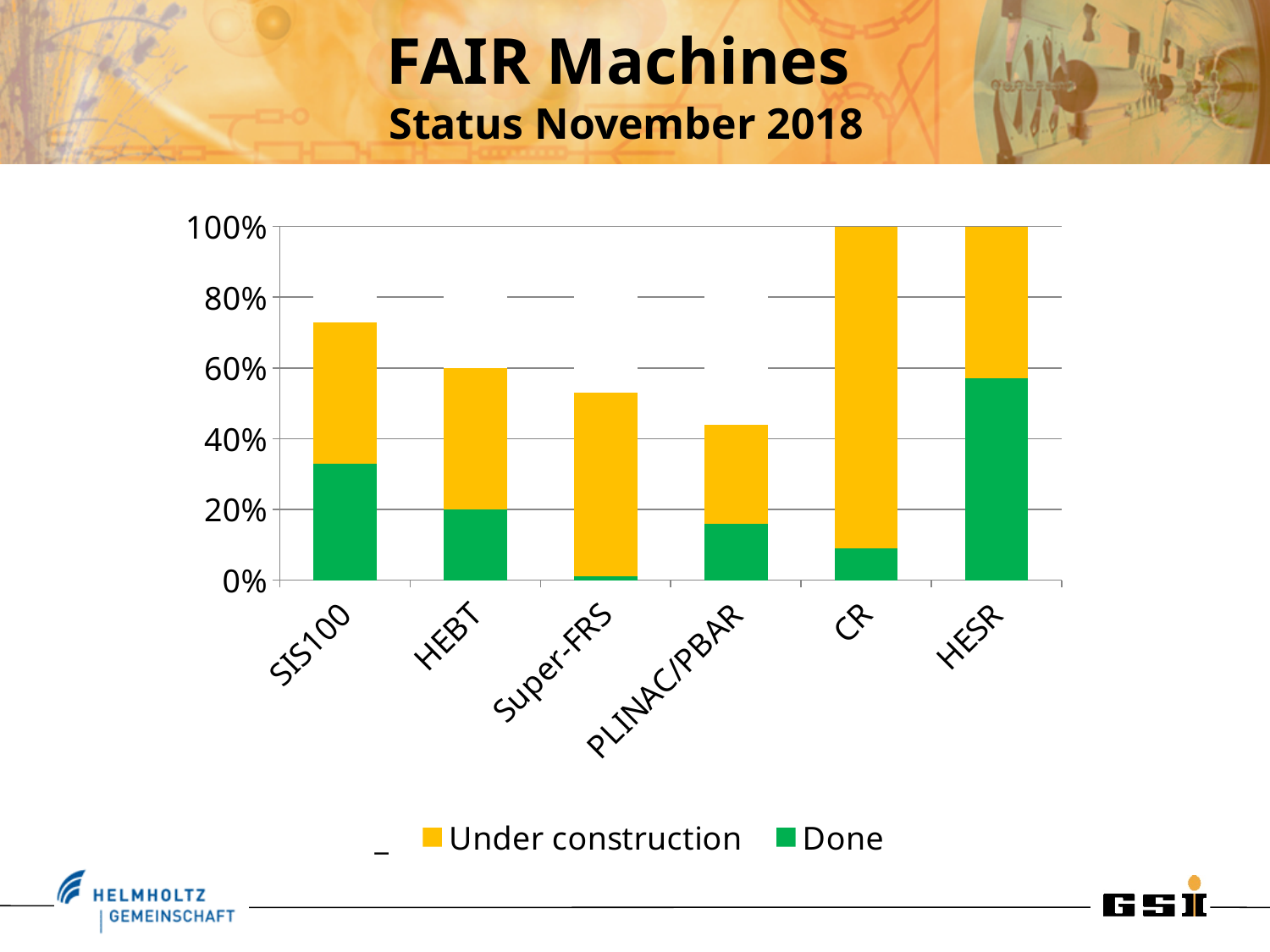
Is the 'Done' value for CR greater or less than 20%? less Is the 'Done' value for HESR greater or less than 40%? greater Which colour represents the 'Done' series? green What kind of chart is shown on the slide? bar chart Is the total height of the PLINAC/PBAR bar greater or less than 60%? less Which machine has the lowest 'Done' value? Super-FRS What are the two series named in the legend? Under construction, Done How many series does the legend list? 3 Which has a larger 'Done' value, SIS100 or HEBT? SIS100 How many machines (categories) are shown on the x axis? 6 Which machine has the highest 'Done' value? HESR